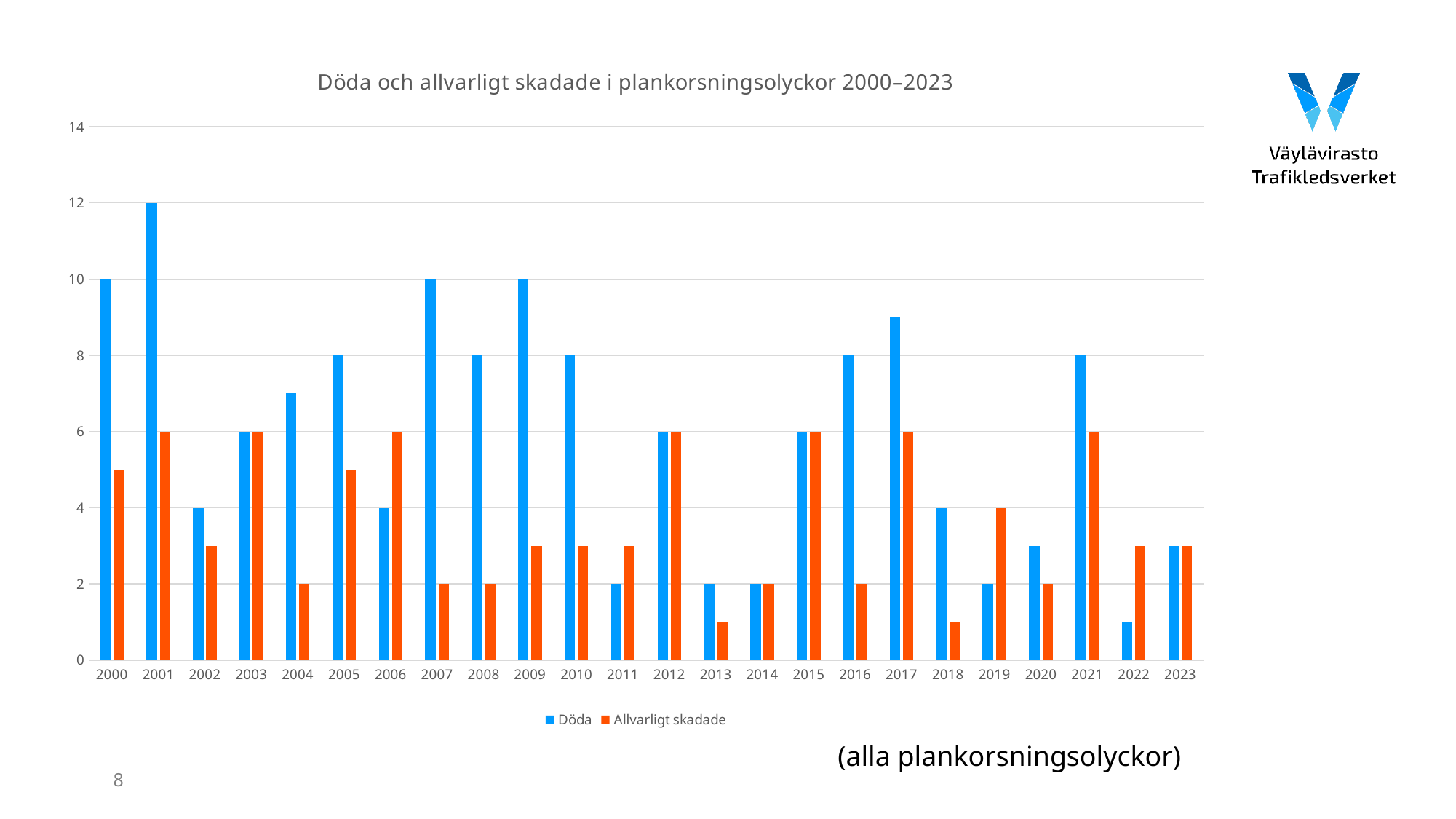
What is the value for Allvarligt skadade in 2012? 6 How many series does the legend list? 2 What is the value for Döda in 2001? 12 How many years are shown on the x axis? 24 What is the title of the chart? Döda och allvarligt skadade i plankorsningsolyckor 2000–2023 Does the value for Döda rise or fall from 2009 to 2011? fall Is the value for Döda in 2017 greater or less than 8? greater In which year is the value for Döda lowest? 2022 In which year is the value for Döda highest? 2001 What type of chart is shown on the slide? bar chart Which is larger in 2019, Döda or Allvarligt skadade? Allvarligt skadade What is the difference between Döda and Allvarligt skadade in 2001? 6